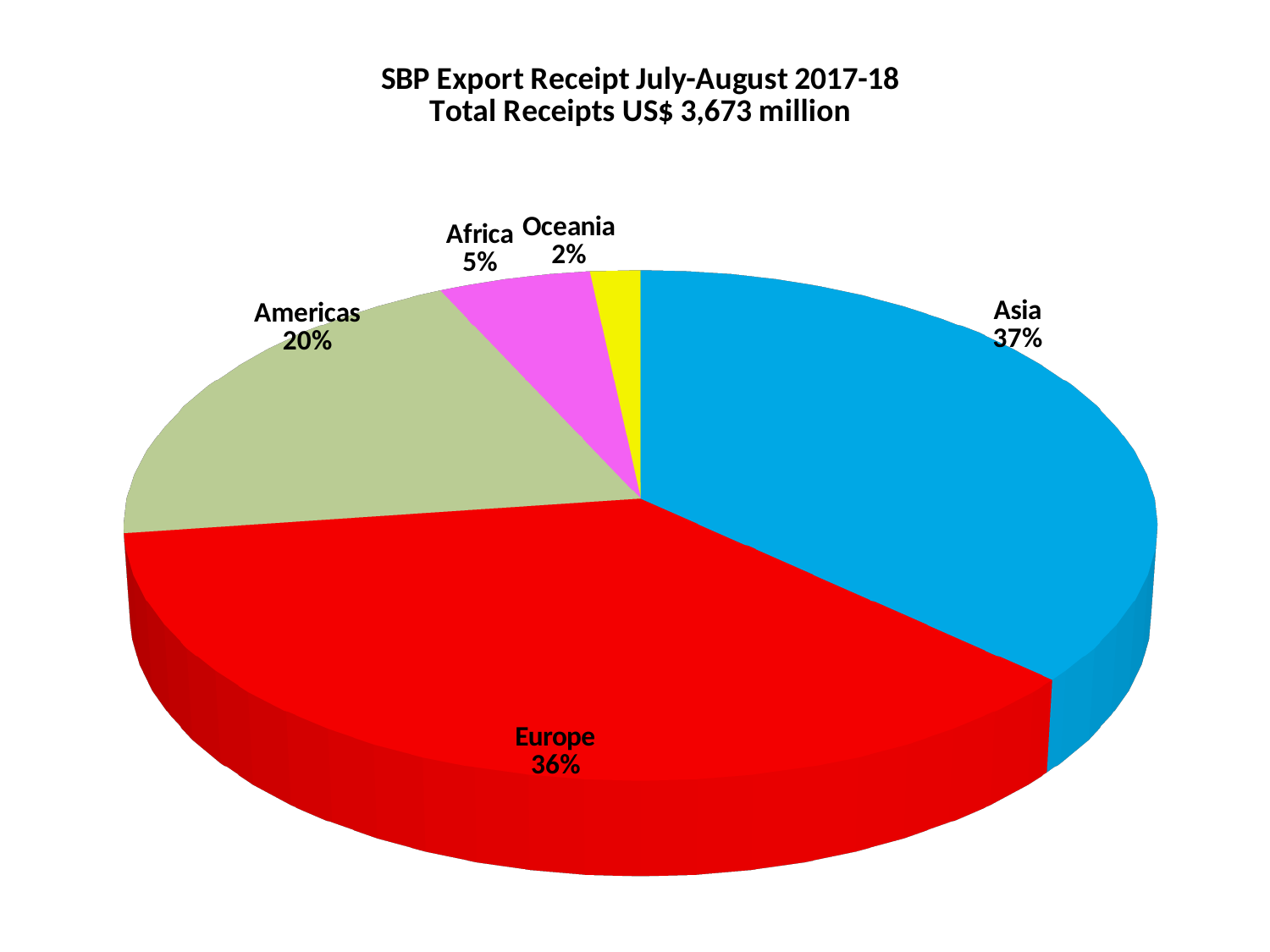
What share of SBP export receipts does Oceania account for? 2% What share of SBP export receipts does Europe account for? 36% What share of SBP export receipts does Africa account for? 5% How many regions are shown in the pie chart? 5 What kind of chart is shown on the slide? Pie chart What total receipts figure is stated in the chart title? US$ 3,673 million Which region has the smallest share of SBP export receipts? Oceania Which region has the largest share of SBP export receipts? Asia What is the difference in percentage points between the Americas share and the Africa share? 15 Which has a larger share of SBP export receipts, Americas or Africa? Americas